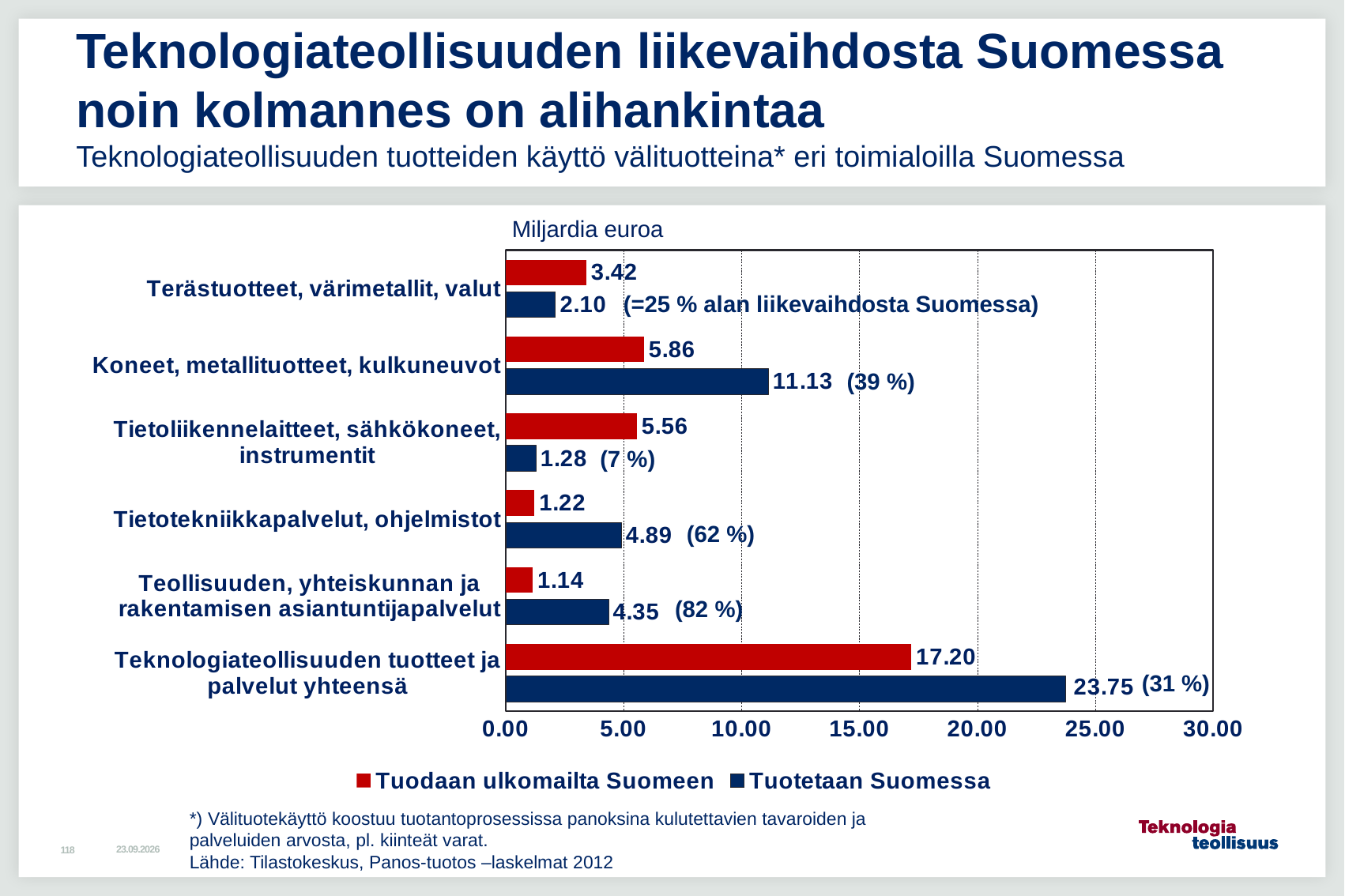
What is the value of "Tuotetaan Suomessa" for Koneet, metallituotteet, kulkuneuvot? 11.13 Is the value of "Tuodaan ulkomailta Suomeen" for Teknologiateollisuuden tuotteet ja palvelut yhteensä greater or less than 15.00? greater What kind of chart is shown on the slide? Bar chart Which category has the lowest value for "Tuodaan ulkomailta Suomeen"? Teollisuuden, yhteiskunnan ja rakentamisen asiantuntijapalvelut How many series does the legend list? 2 What is the value of "Tuodaan ulkomailta Suomeen" for Tietoliikennelaitteet, sähkökoneet, instrumentit? 5.56 What is the difference between "Tuotetaan Suomessa" and "Tuodaan ulkomailta Suomeen" for Tietotekniikkapalvelut, ohjelmistot? 3.67 How many categories are shown on the chart? 6 For Terästuotteet, värimetallit, valut, which is larger: "Tuodaan ulkomailta Suomeen" or "Tuotetaan Suomessa"? Tuodaan ulkomailta Suomeen What is the value of "Tuotetaan Suomessa" for Teknologiateollisuuden tuotteet ja palvelut yhteensä? 23.75 What unit is shown above the chart? Miljardia euroa Excluding the total row, which category has the highest value for "Tuotetaan Suomessa"? Koneet, metallituotteet, kulkuneuvot